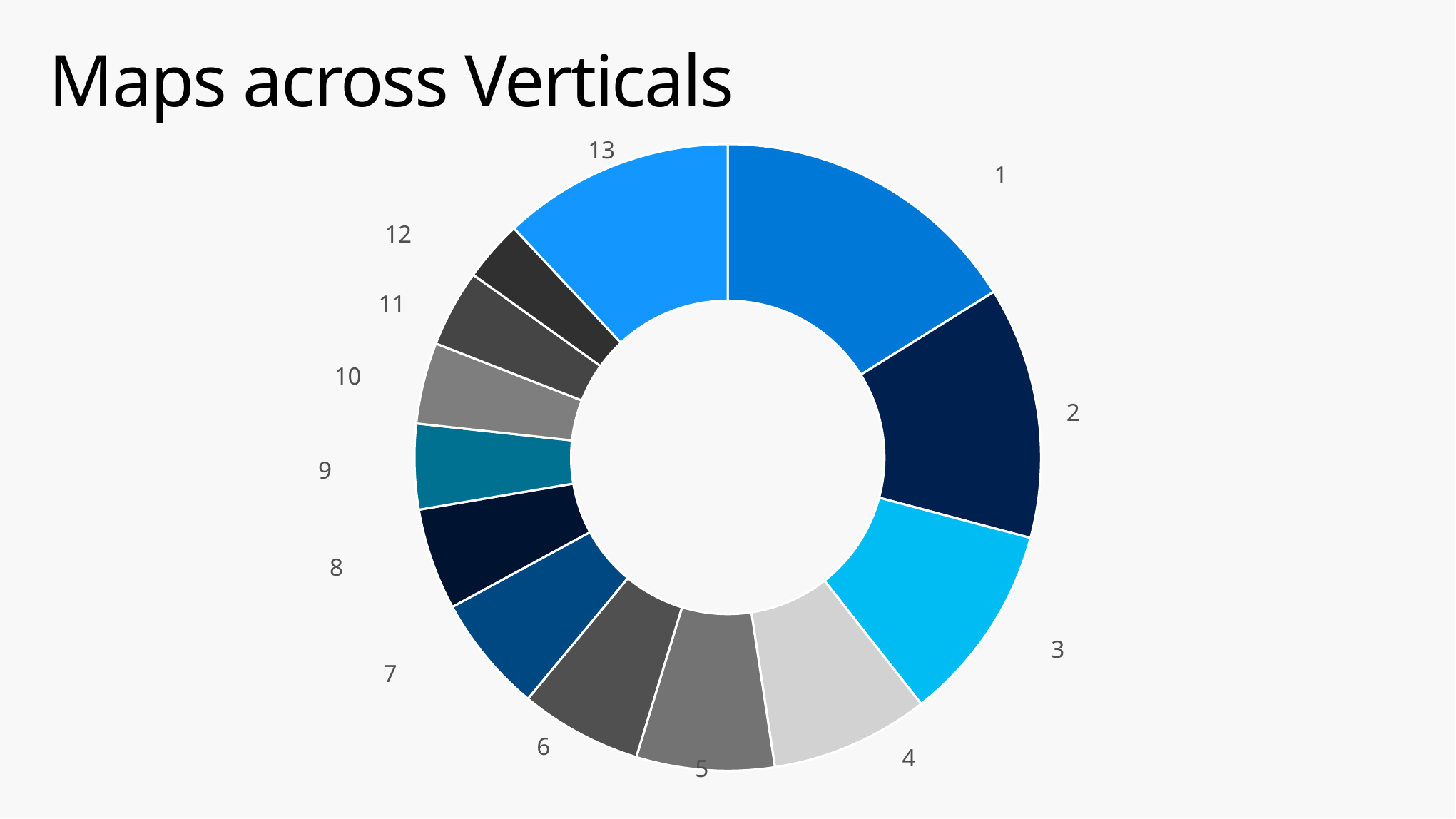
What colour is slice 4 in the doughnut chart? Light grey Which slice is larger, slice 13 or slice 10? 13 Which slice is larger, slice 1 or slice 9? 1 What kind of chart is shown on the slide? Doughnut (pie) chart What is the title of the slide? Maps across Verticals Which slice is the largest in the doughnut chart? 1 Which slice is larger, slice 2 or slice 11? 2 How many slices does the doughnut chart have? 13